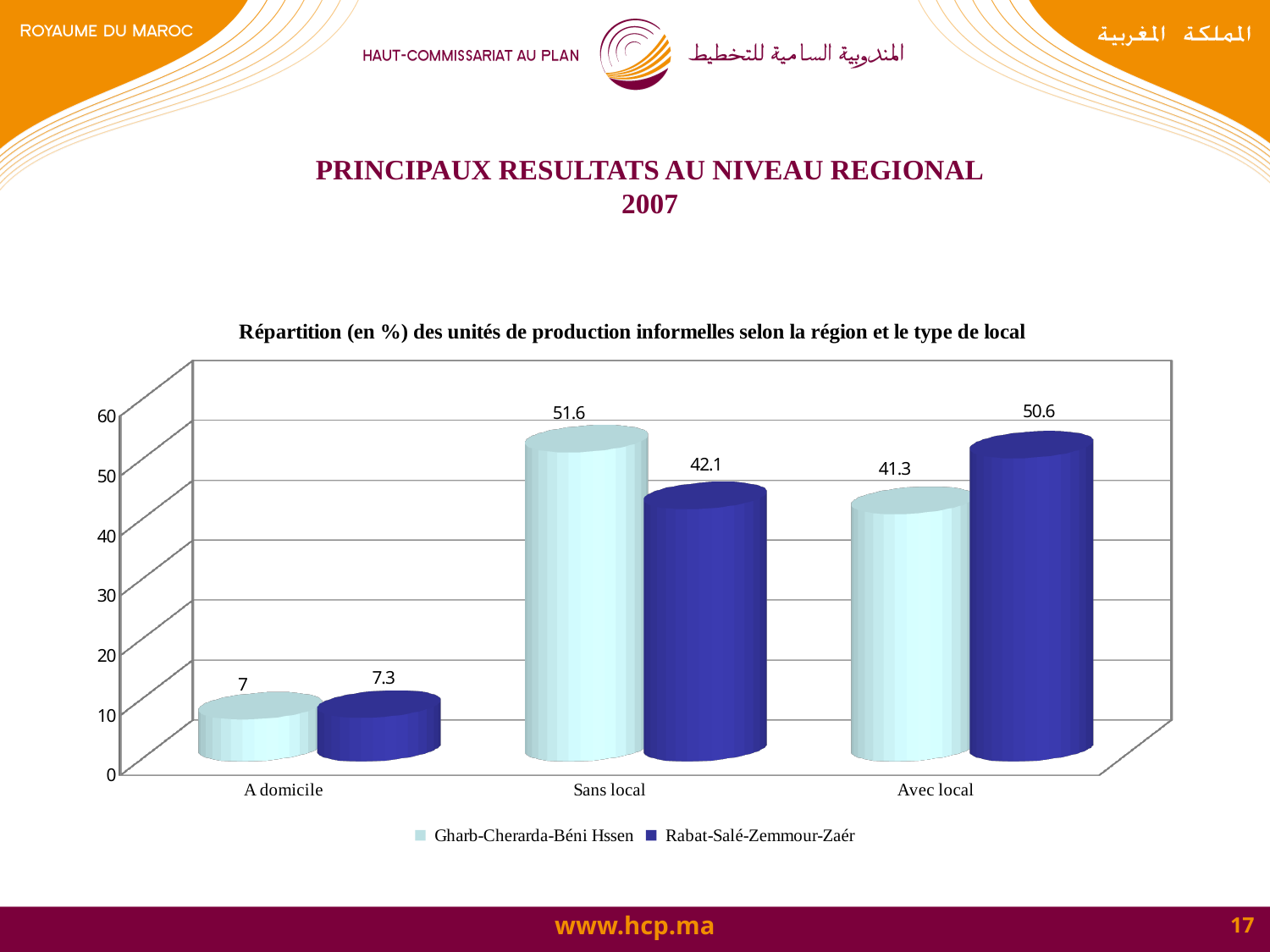
What is the title of the chart? Répartition (en %) des unités de production informelles selon la région et le type de local Which category has the lowest value for Rabat-Salé-Zemmour-Zaér? A domicile What is the value for Rabat-Salé-Zemmour-Zaér in the Avec local category? 50.6 How many series does the legend list? 2 In the Avec local category, which region has the larger value? Rabat-Salé-Zemmour-Zaér What is the difference between the two regions in the Sans local category? 9.5 What kind of chart is shown on the slide? Bar chart What is the difference between the two regions in the Avec local category? 9.3 Which category has the highest value for Gharb-Cherarda-Béni Hssen? Sans local How many categories are shown on the x axis? 3 What is the value for Rabat-Salé-Zemmour-Zaér in the A domicile category? 7.3 What is the value for Gharb-Cherarda-Béni Hssen in the Sans local category? 51.6